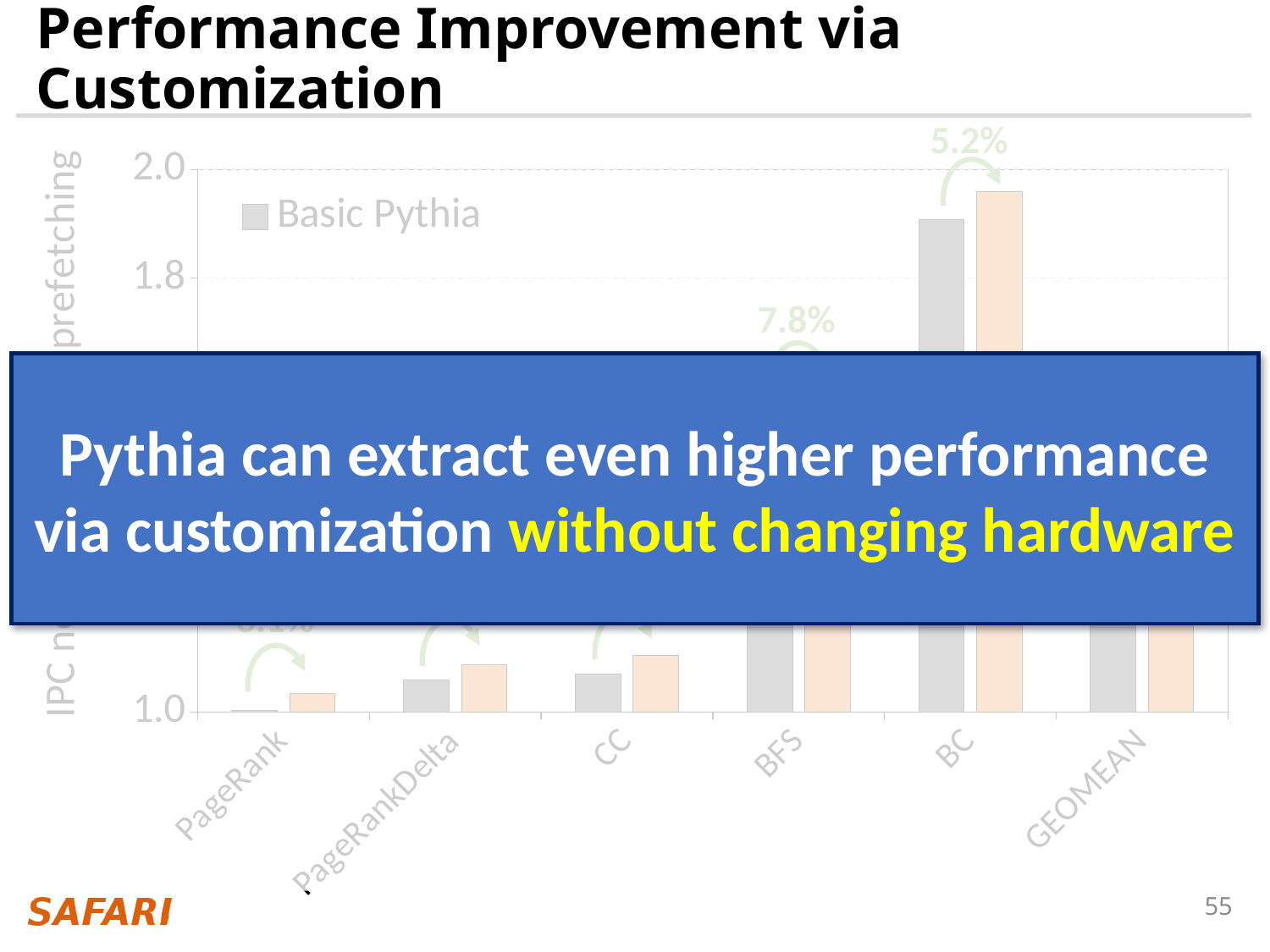
Is the Basic Pythia value for PageRank greater or less than 1.8? less For BC, which bar is taller: the grey Basic Pythia bar or the orange bar? the orange bar How many categories are shown along the x axis of the chart? 6 Which category has the shortest bars in the chart? PageRank Is the Basic Pythia value for BC greater or less than 1.8? greater What percentage improvement is labelled above the BFS bars? 7.8% What is the title of the slide containing the chart? Performance Improvement via Customization What kind of chart is shown on the slide? bar chart Which category has a higher Basic Pythia value, BC or PageRank? BC What percentage improvement is labelled above the BC bars? 5.2% Which category has the tallest bars in the chart? BC What is the legend entry shown for the grey bars? Basic Pythia